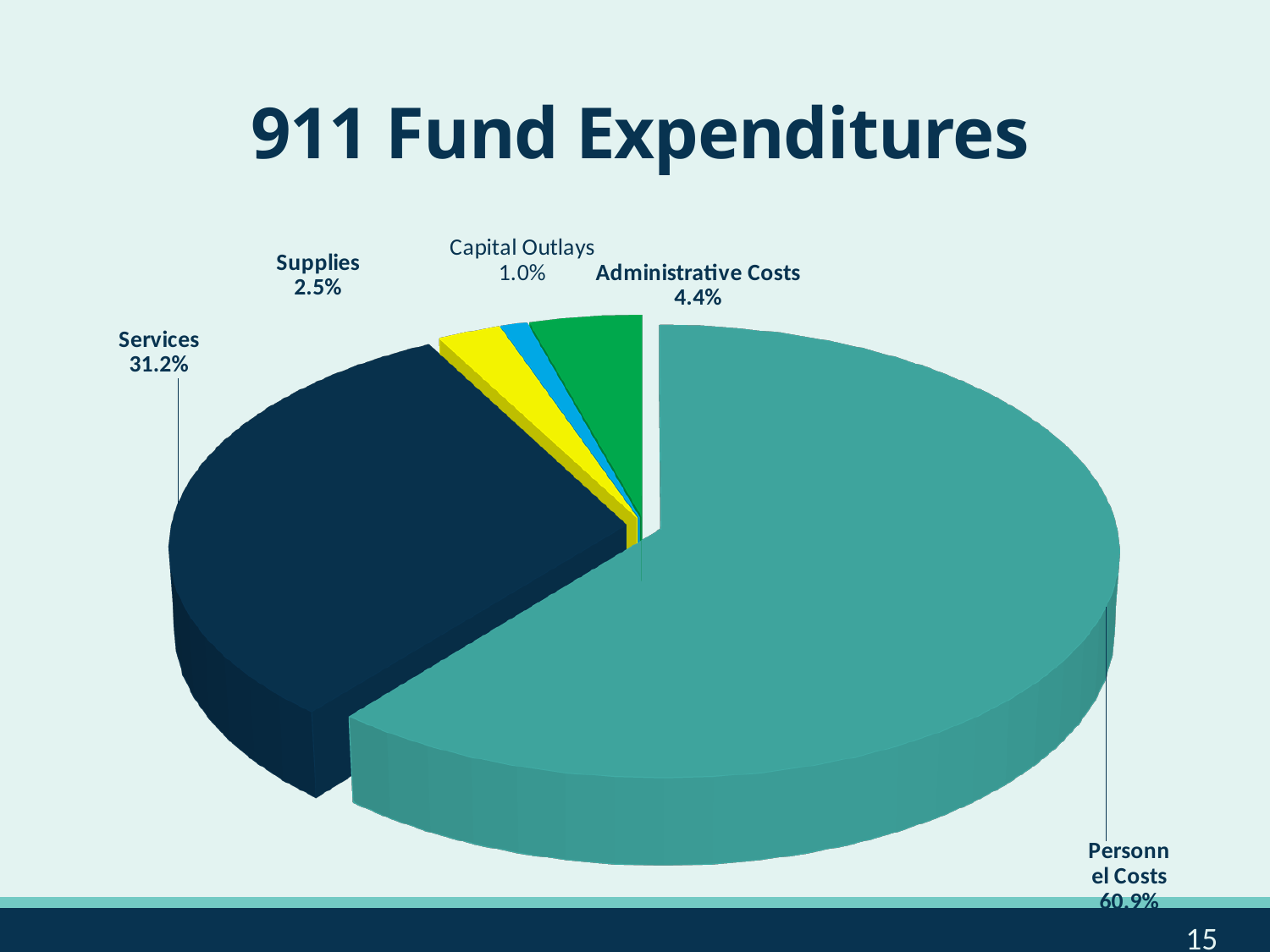
What is the title of the chart? 911 Fund Expenditures What type of chart is shown on the slide? Pie chart What percentage of the pie is Administrative Costs? 4.4% Which category has the smallest share of the pie? Capital Outlays What is the difference in percentage points between Supplies and Capital Outlays? 1.5% Which category has the largest share of the pie? Personnel Costs How many categories are shown in the pie chart? 5 Which is larger, the share for Services or the share for Administrative Costs? Services What share of expenditures goes to Supplies? 2.5% What share of 911 Fund Expenditures is Services? 31.2%